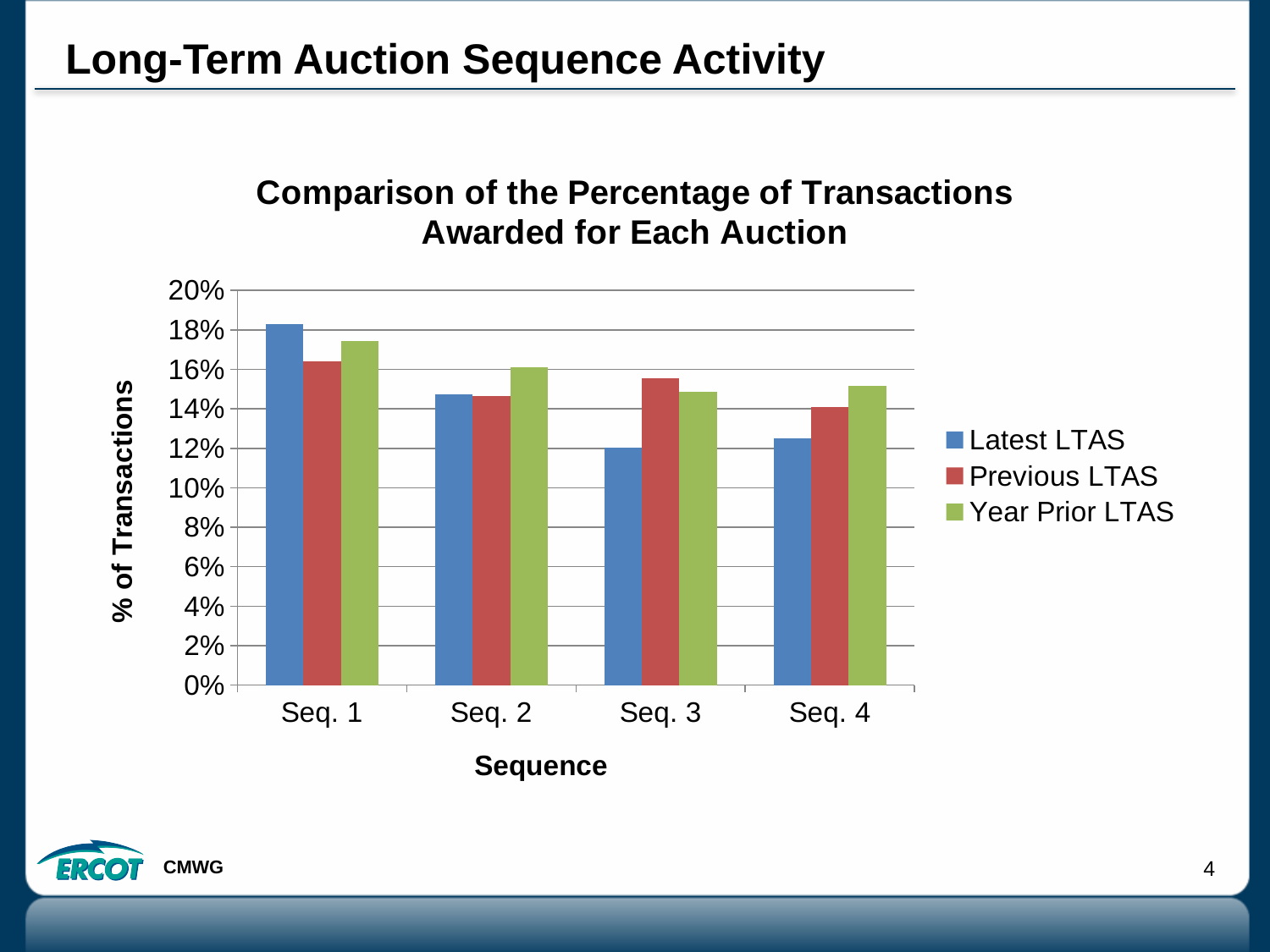
Does the Latest LTAS value rise or fall from Seq. 1 to Seq. 3? fall How many series does the legend list? 3 How many sequence categories are shown on the x axis? 4 For which sequence is the Latest LTAS value lowest? Seq. 3 Is the Previous LTAS value for Seq. 3 greater or less than 14%? greater Is the Latest LTAS value for Seq. 1 greater or less than 16%? greater Is the Latest LTAS value for Seq. 3 greater or less than 14%? less For Seq. 3, which is larger: Latest LTAS or Previous LTAS? Previous LTAS For which sequence is the Latest LTAS value highest? Seq. 1 What is the title of the vertical axis? % of Transactions For Seq. 1, which is larger: Latest LTAS or Previous LTAS? Latest LTAS What kind of chart is shown on the slide? Bar chart